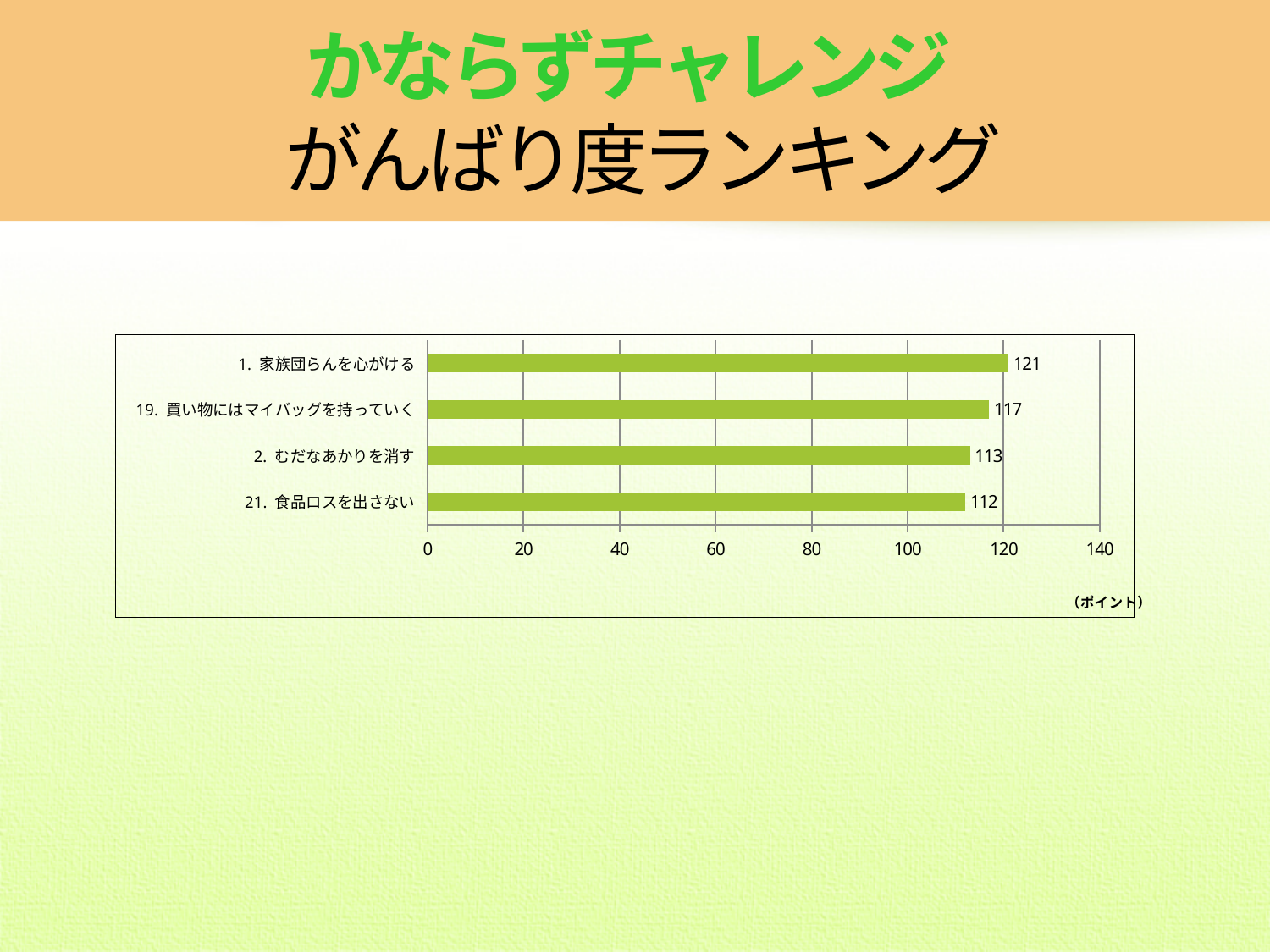
What is the value for 21. 食品ロスを出さない? 112 Which is larger, the value for 19. 買い物にはマイバッグを持っていく or the value for 2. むだなあかりを消す? 19. 買い物にはマイバッグを持っていく What kind of chart is shown on the slide? bar chart What is the difference between the values for 1. 家族団らんを心がける and 21. 食品ロスを出さない? 9 How many categories are shown in the chart? 4 What unit is indicated in the bottom-right corner of the chart? ポイント Is the value for 1. 家族団らんを心がける greater or less than 120? greater What is the value for 2. むだなあかりを消す? 113 What is the value for 19. 買い物にはマイバッグを持っていく? 117 Which category has the lowest value? 21. 食品ロスを出さない What is the value for 1. 家族団らんを心がける? 121 Which category has the highest value? 1. 家族団らんを心がける